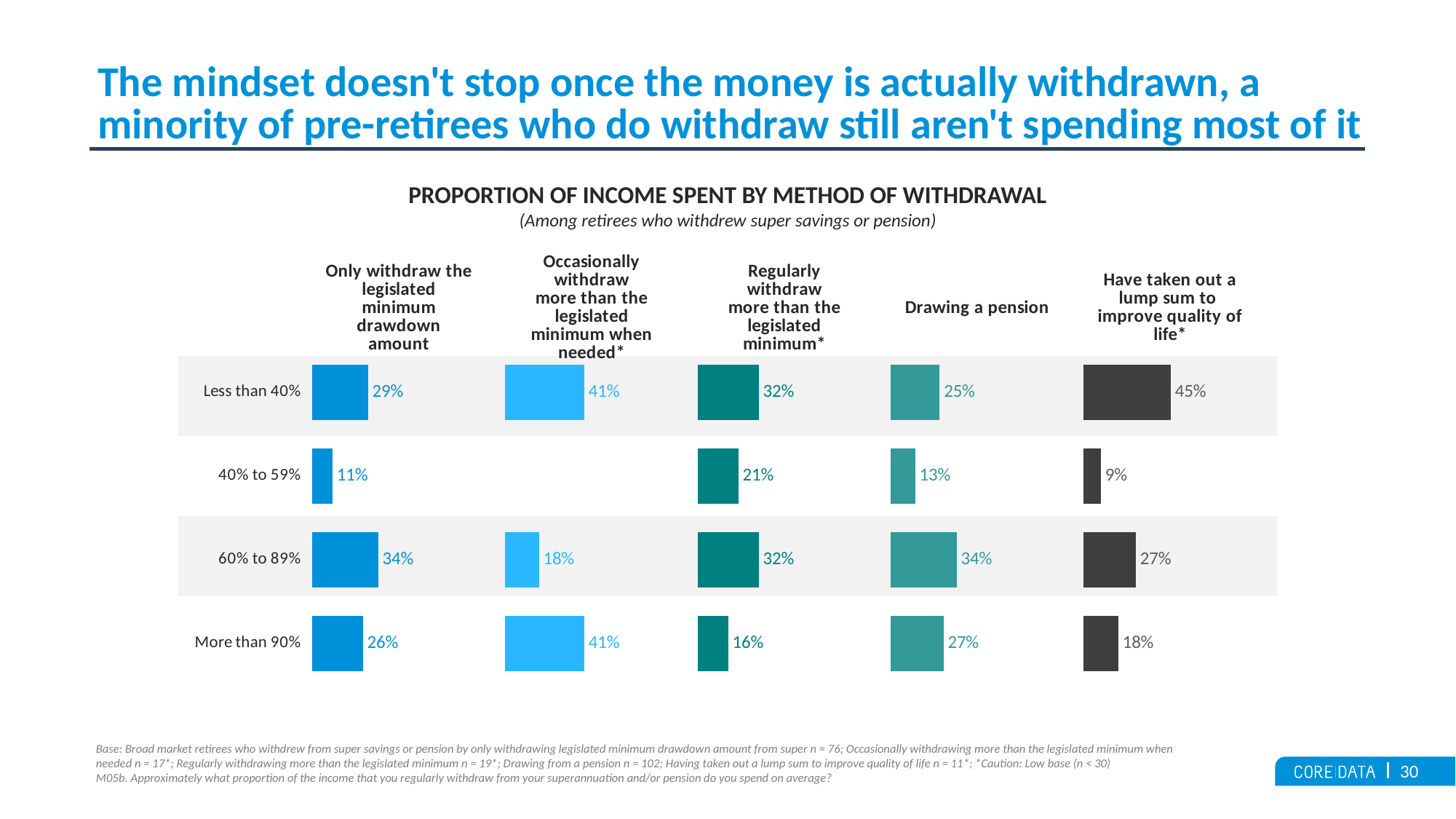
What percentage of retirees who have taken out a lump sum to improve quality of life spend less than 40% of their income? 45% How many proportion-of-income-spent categories are shown in the chart? 4 How many withdrawal methods are shown in the chart? 5 What percentage of retirees who only withdraw the legislated minimum drawdown amount spend less than 40% of their income? 29% Which withdrawal method has the highest share of retirees spending less than 40% of their income? Have taken out a lump sum to improve quality of life What percentage of retirees drawing a pension spend 60% to 89% of their income? 34% What type of chart is shown on the slide? Bar chart What percentage of retirees who occasionally withdraw more than the legislated minimum when needed spend more than 90% of their income? 41% What is the title of the chart? PROPORTION OF INCOME SPENT BY METHOD OF WITHDRAWAL For retirees spending more than 90% of their income, which is larger: the value for 'Drawing a pension' or the value for 'Have taken out a lump sum to improve quality of life'? Drawing a pension What is the difference between the 'Less than 40%' and 'More than 90%' values for retirees who regularly withdraw more than the legislated minimum? 16%